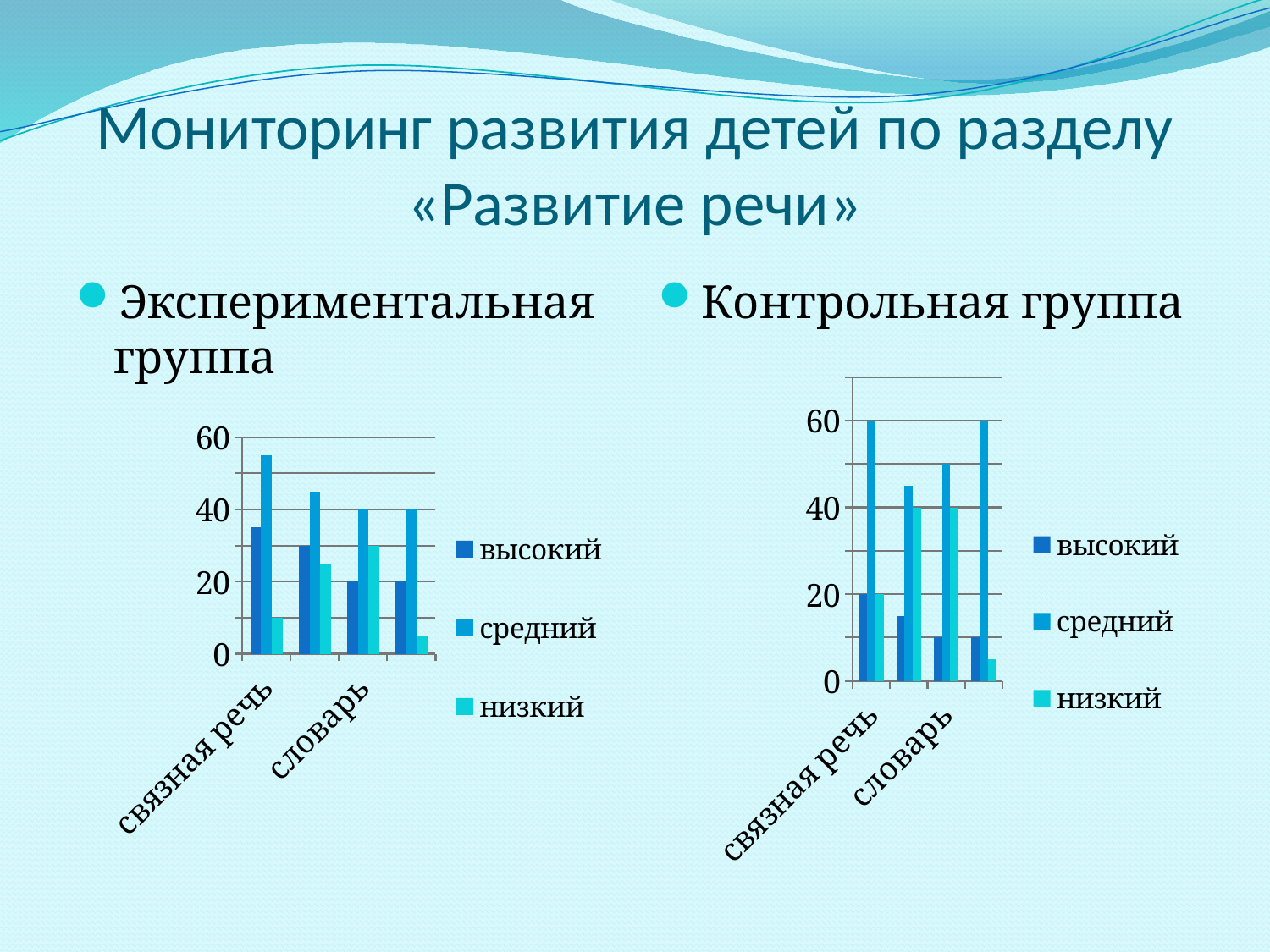
What is the highest value shown on the vertical axis of the «Контрольная группа» chart? 60 In the «Контрольная группа» chart, which series has the highest bar for «связная речь»? средний What are the three legend entries in the «Экспериментальная группа» chart? высокий, средний, низкий In the «Экспериментальная группа» chart, is the value of «низкий» for «связная речь» greater or less than 20? less In the «Контрольная группа» chart, which is larger for «словарь»: «высокий» or «низкий»? низкий In the «Экспериментальная группа» chart, which is larger for «связная речь»: «высокий» or «средний»? средний What kind of chart is shown under «Экспериментальная группа»? bar chart In the «Контрольная группа» chart, is the value of «низкий» for «словарь» greater or less than 20? greater In the «Экспериментальная группа» chart, is the value of «средний» for «связная речь» greater or less than 40? greater How many series does the legend of the «Контрольная группа» chart list? 3